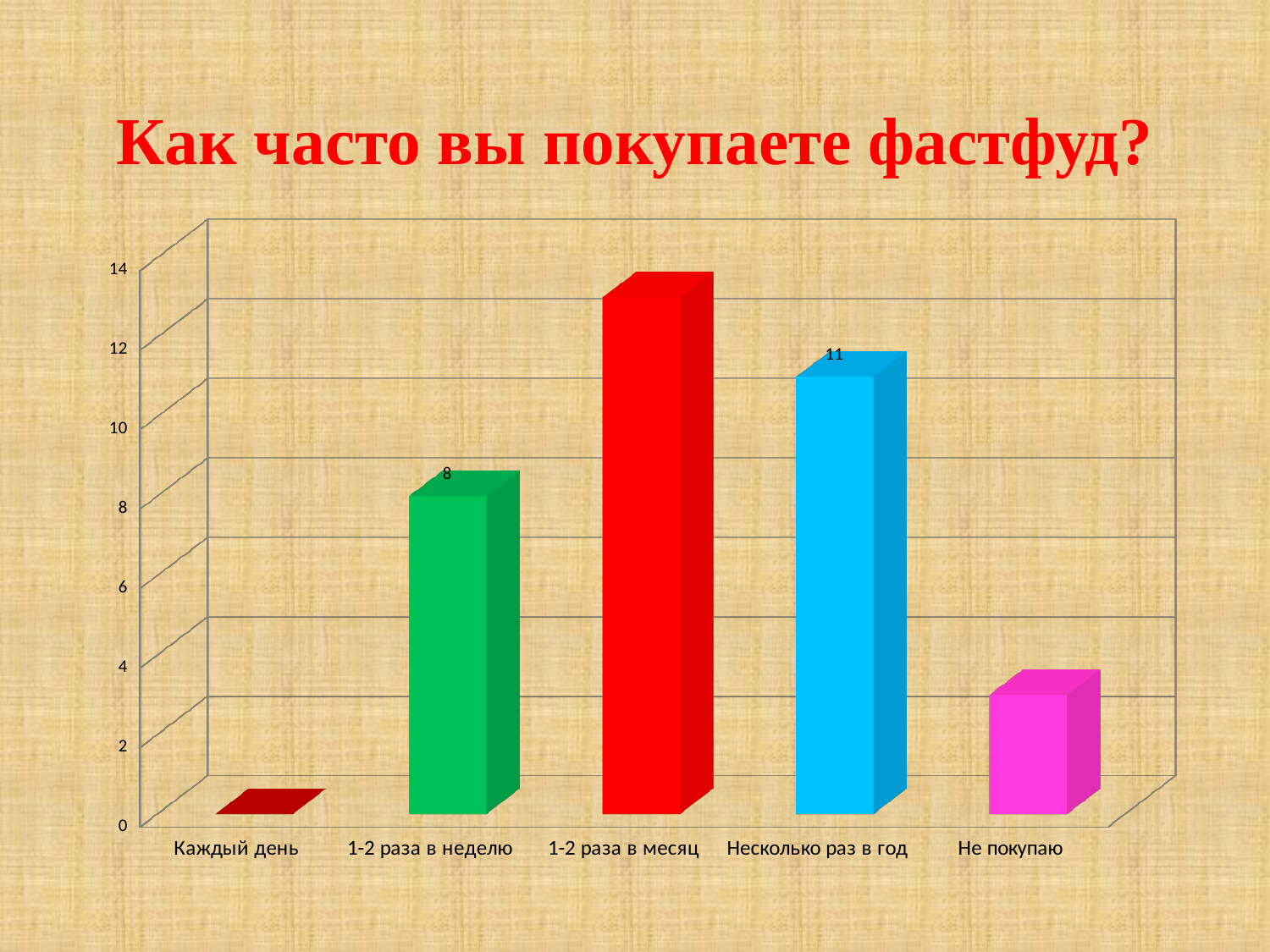
What kind of chart is shown on the slide? bar chart Is the value for «1-2 раза в месяц» greater or less than 12? greater How many categories are shown on the x axis? 5 What is the value for «Несколько раз в год»? 11 Is the value for «Каждый день» greater or less than 2? less Is the value for «Не покупаю» greater or less than 4? less What is the value for «1-2 раза в неделю»? 8 Which is larger: the value for «Несколько раз в год» or the value for «1-2 раза в неделю»? Несколько раз в год What is the difference between the values for «Несколько раз в год» and «1-2 раза в неделю»? 3 Which category has the highest bar? 1-2 раза в месяц What is the title of the slide? Как часто вы покупаете фастфуд? Which category has the lowest bar? Каждый день